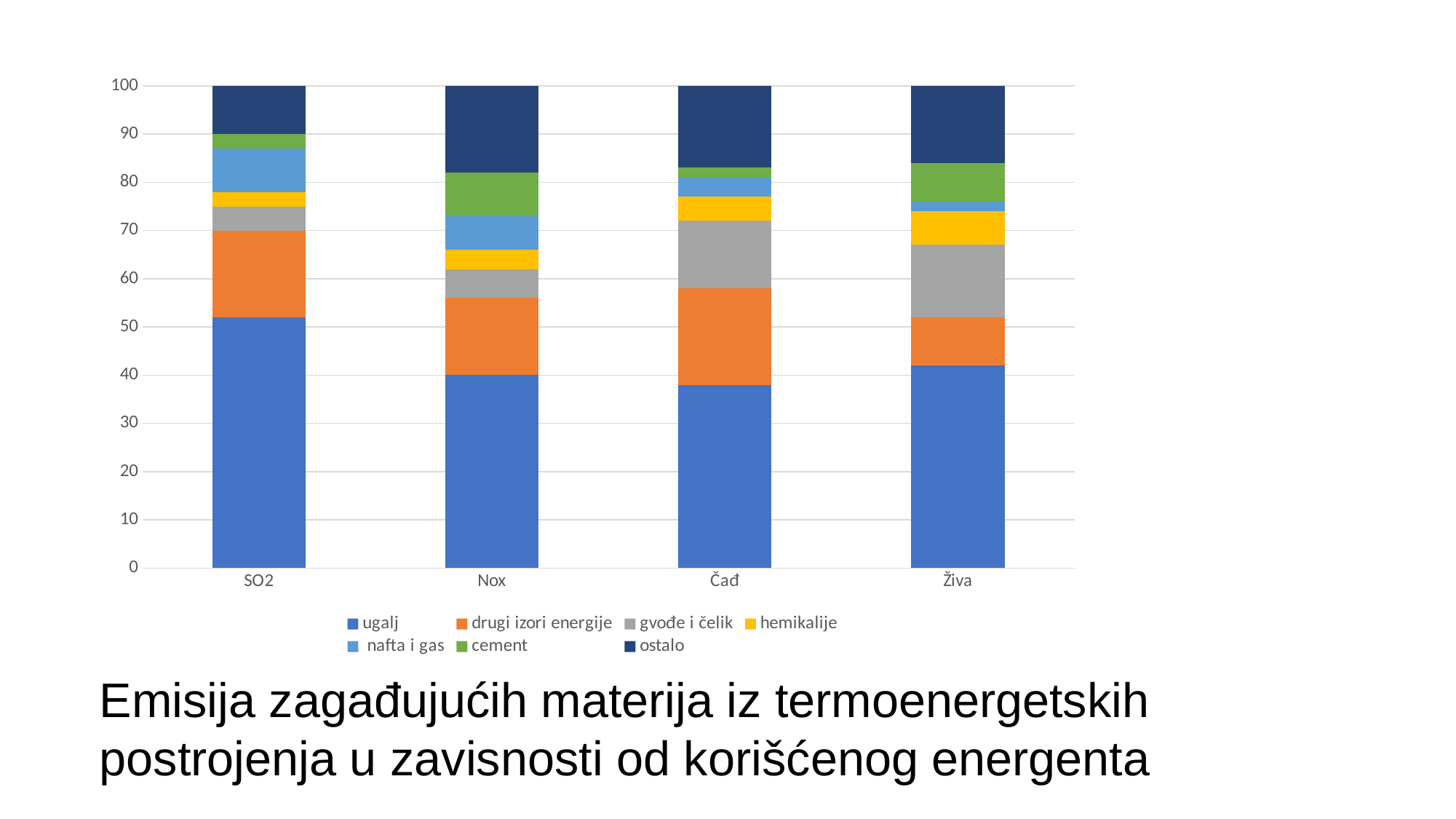
Which category has the largest ugalj segment? SO2 How many categories are shown on the x axis of the chart? 4 Is the ugalj value for SO2 greater or less than 40? greater What kind of chart is shown on the slide? Stacked bar chart What is the total height of the stacked bar for SO2? 100 Is the ugalj segment larger for SO2 or for Nox? SO2 Which category has the smallest ostalo segment? SO2 Which series is listed first in the chart's legend? ugalj How many series does the chart's legend list? 7 Is the ugalj value for Čađ greater or less than 50? less Which category has the smallest nafta i gas segment? Živa What is the total height of the stacked bar for Živa? 100